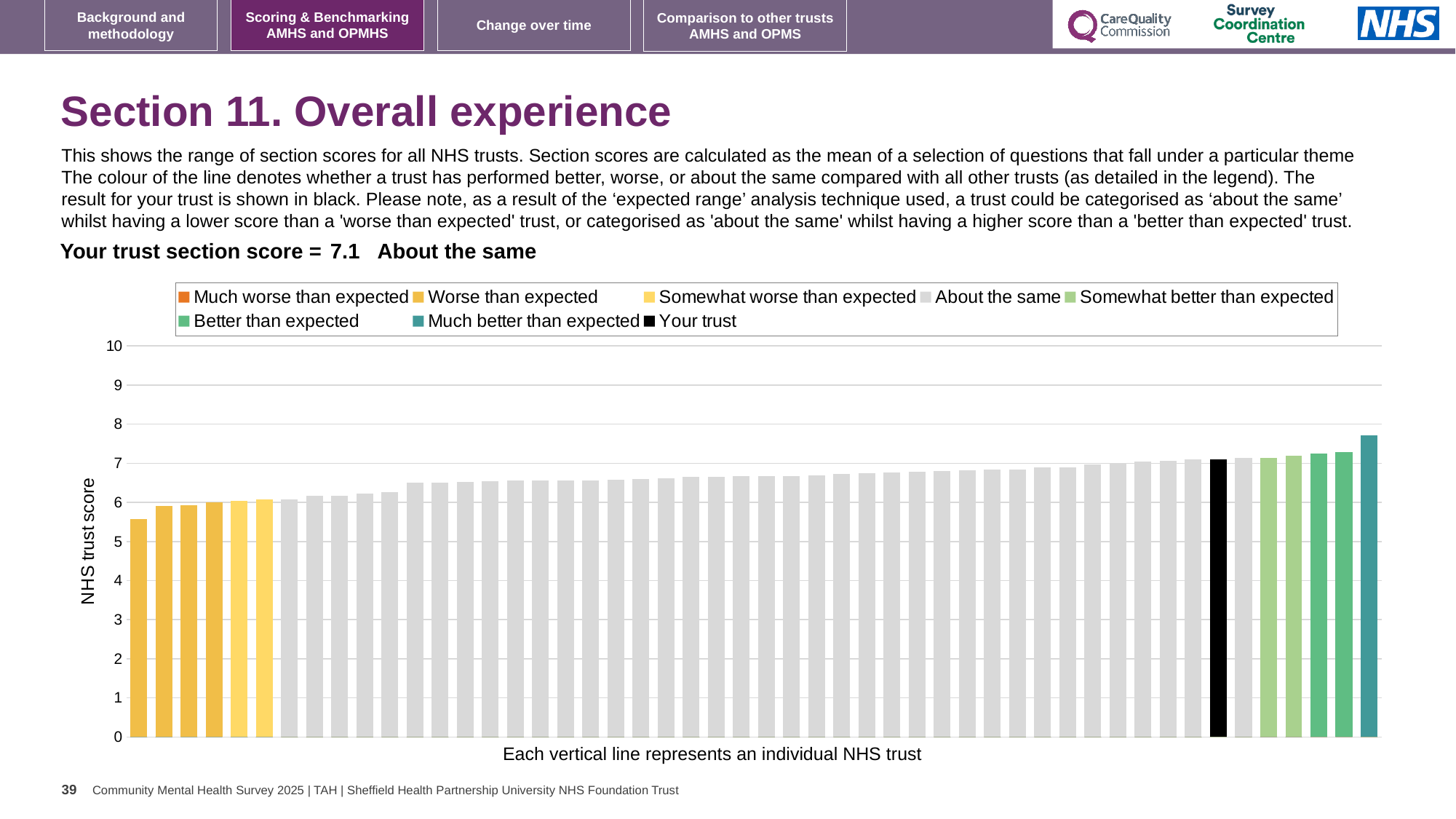
What kind of chart is shown on the slide? bar chart Is the black 'Your trust' bar taller or shorter than the teal 'Much better than expected' bar? shorter Which legend category does the shortest bar belong to? Worse than expected What is the label on the vertical axis of the chart? NHS trust score How many entries does the chart legend list? 8 Is the value of the black 'Your trust' bar greater or less than 6? greater What colour is used for the 'Your trust' bar in the chart? black Is the value of the shortest bar greater or less than 5? greater Which legend category does the tallest bar belong to? Much better than expected Do the bar values rise or fall from left to right along the x axis? rise What is the section score for your trust shown on the slide? 7.1 Is the value of the tallest bar greater or less than 8? less